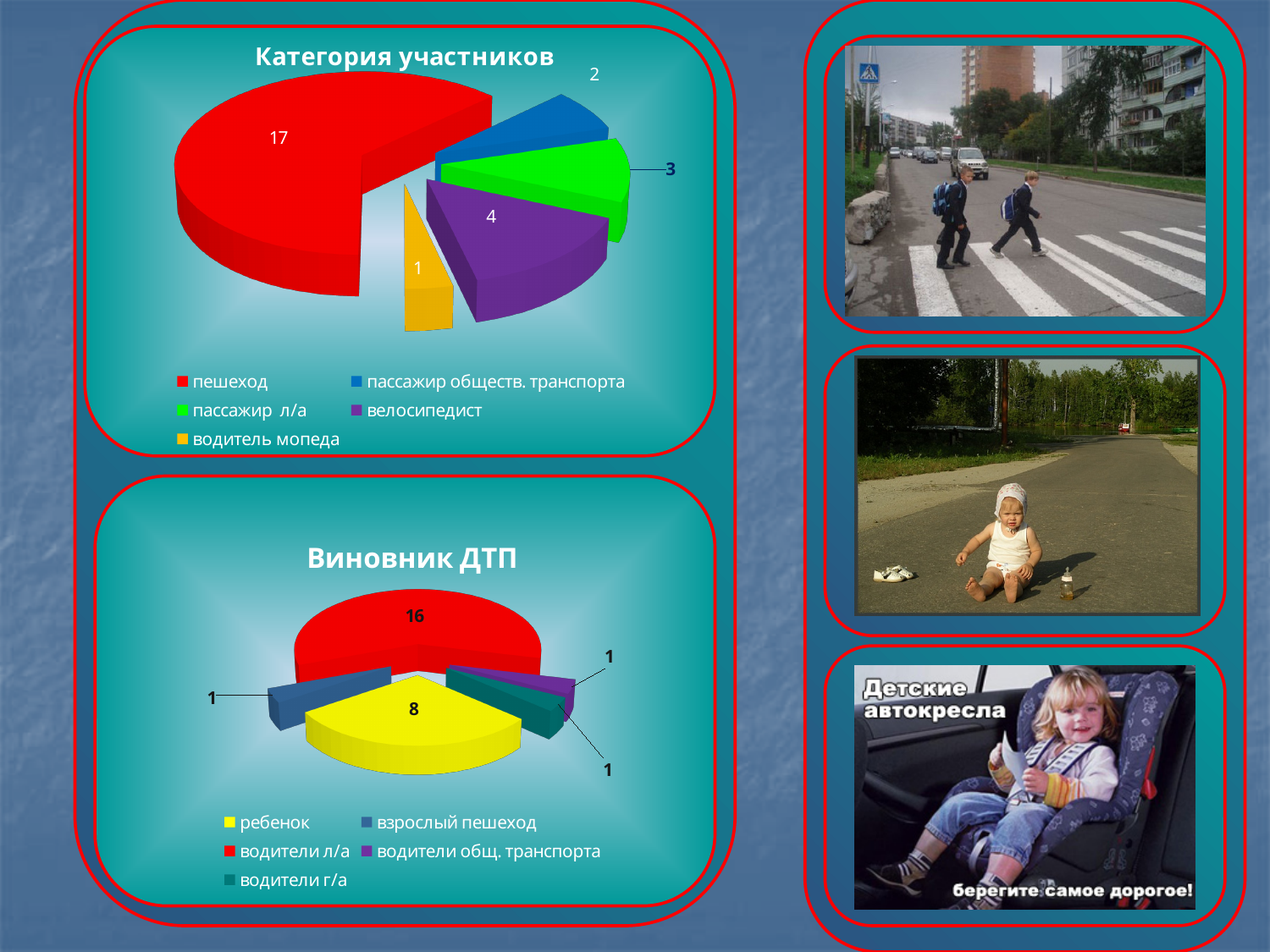
In the chart titled "Категория участников", what is the difference between пешеход and велосипедист? 13 In the chart titled "Категория участников", how many categories does the legend list? 5 In the chart titled "Категория участников", what is the value for пешеход? 17 In the chart titled "Виновник ДТП", which category has the largest slice? водители л/а In the chart titled "Категория участников", which category has the largest slice? пешеход What kind of chart is the chart titled "Виновник ДТП"? pie chart In the chart titled "Виновник ДТП", what is the value for водители л/а? 16 In the chart titled "Виновник ДТП", which is larger: ребенок or взрослый пешеход? ребенок In the chart titled "Виновник ДТП", what is the value for ребенок? 8 In the chart titled "Категория участников", which category has the smallest slice? водитель мопеда In the chart titled "Категория участников", what is the value for велосипедист? 4 In the chart titled "Виновник ДТП", what colour is the slice for ребенок? yellow